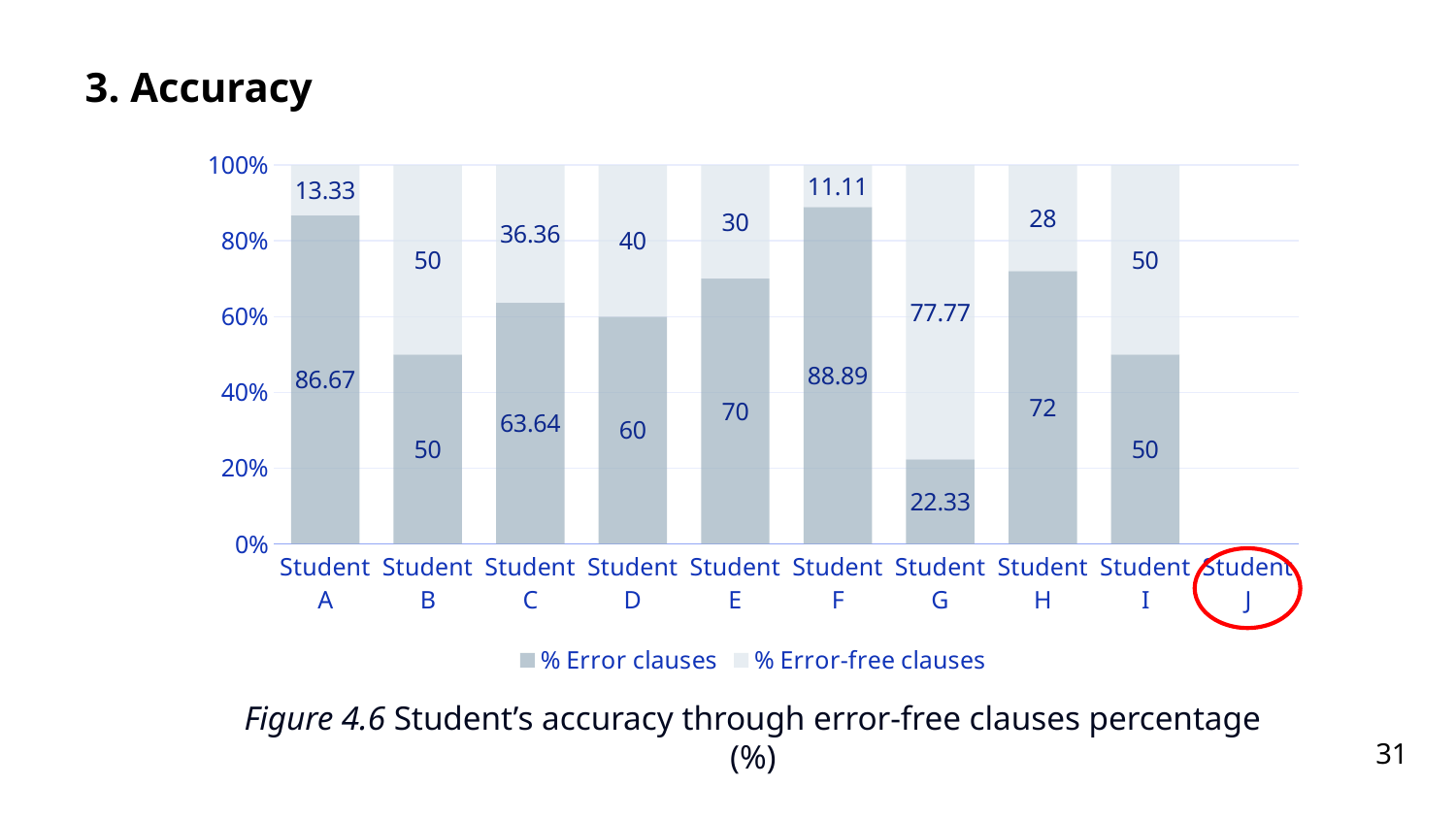
How many student categories are shown on the x axis? 10 What is the % Error-free clauses value for Student G? 77.77 Which student has the highest % Error clauses value? Student F Which student label on the x axis is circled in red? Student J What kind of chart is shown on the slide? Stacked bar chart Which is larger: the % Error clauses value for Student A or for Student B? Student A What is the total of the stacked bar for Student B? 100 Which student has the lowest % Error clauses value? Student G What is the % Error clauses value for Student A? 86.67 How many series does the legend list? 2 What is the difference between the % Error clauses and % Error-free clauses values for Student D? 20 What is the % Error-free clauses value for Student H? 28